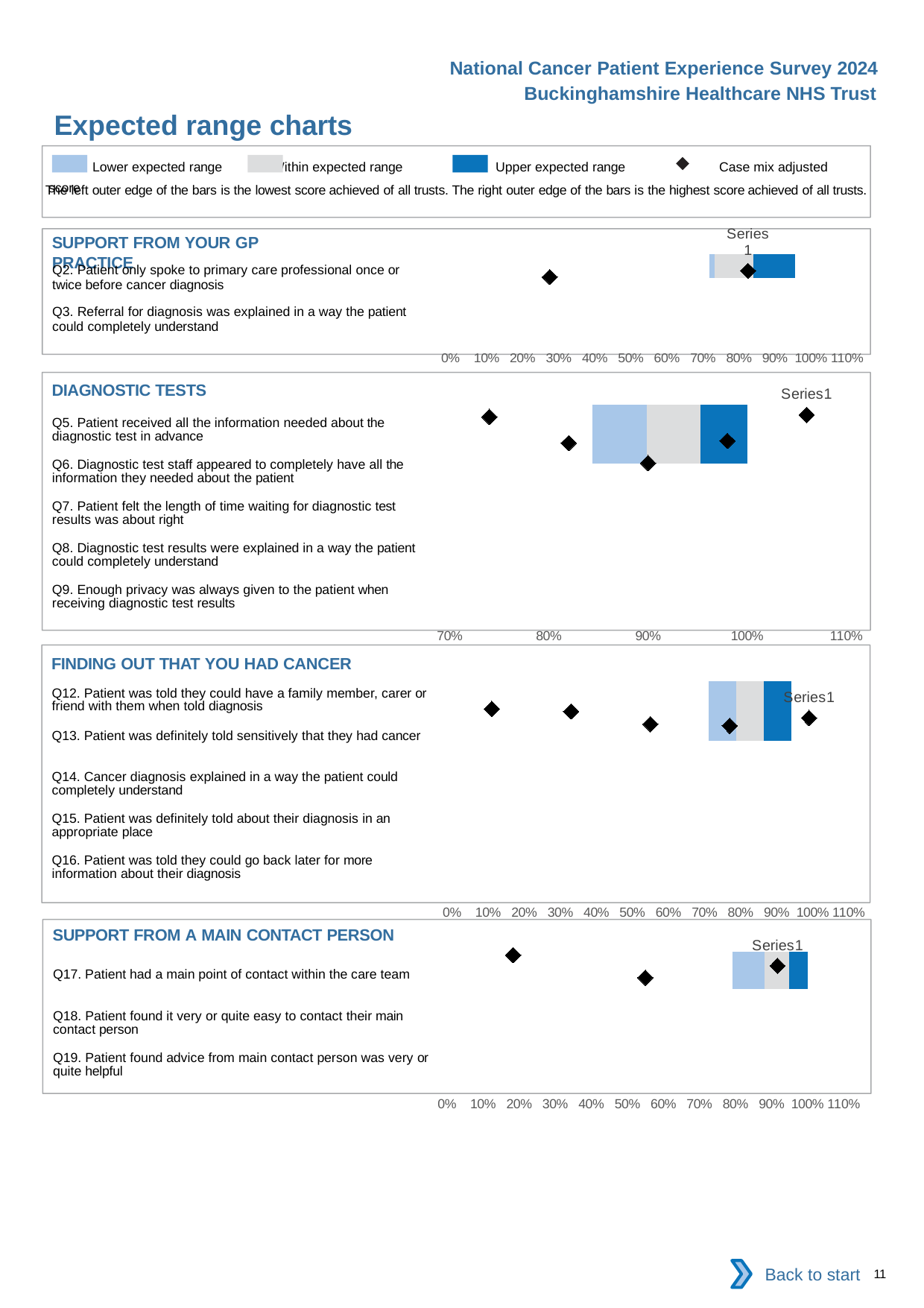
In the DIAGNOSTIC TESTS chart, how many survey questions are listed? 5 In the DIAGNOSTIC TESTS chart, what is the lowest value shown on the x axis? 70% In the SUPPORT FROM A MAIN CONTACT PERSON chart, how many survey questions are listed? 3 What kind of chart is used in the DIAGNOSTIC TESTS panel? bar chart In the SUPPORT FROM YOUR GP PRACTICE chart, how many survey questions are listed? 2 In the SUPPORT FROM A MAIN CONTACT PERSON chart, what is the highest value shown on the x axis? 110% In the DIAGNOSTIC TESTS chart, is the left edge of the expected range bar greater or less than 80%? greater How many entries does the legend at the top of the slide list? 4